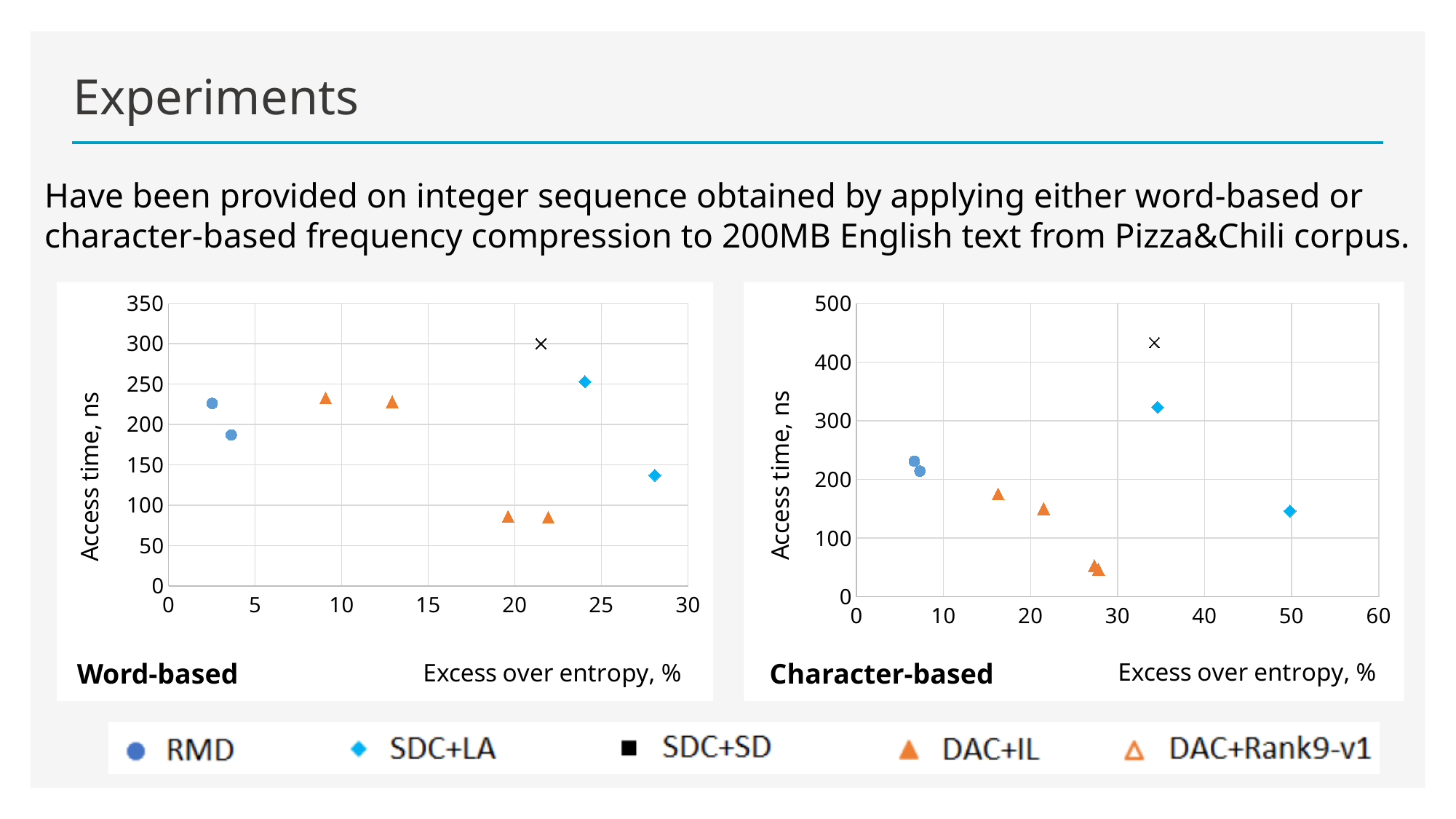
In the Character-based chart, do the DAC+IL access times rise or fall as excess over entropy increases? fall What is the x-axis label of the Word-based chart? Excess over entropy, % In the Character-based chart, is the access time of the SDC+LA point near 50% excess over entropy greater or less than 200? less In the Word-based chart, how many RMD points are plotted? 2 In the Word-based chart, is the access time of the SDC+LA point with the higher access time greater or less than 200? greater In the Character-based chart, is the lowest DAC+IL access time greater or less than 100? less In the Word-based chart, which series reaches a lower access time, RMD or DAC+IL? DAC+IL What is the y-axis label of the Character-based chart? Access time, ns How many series does the legend list? 5 What kind of chart is the Word-based chart? scatter chart